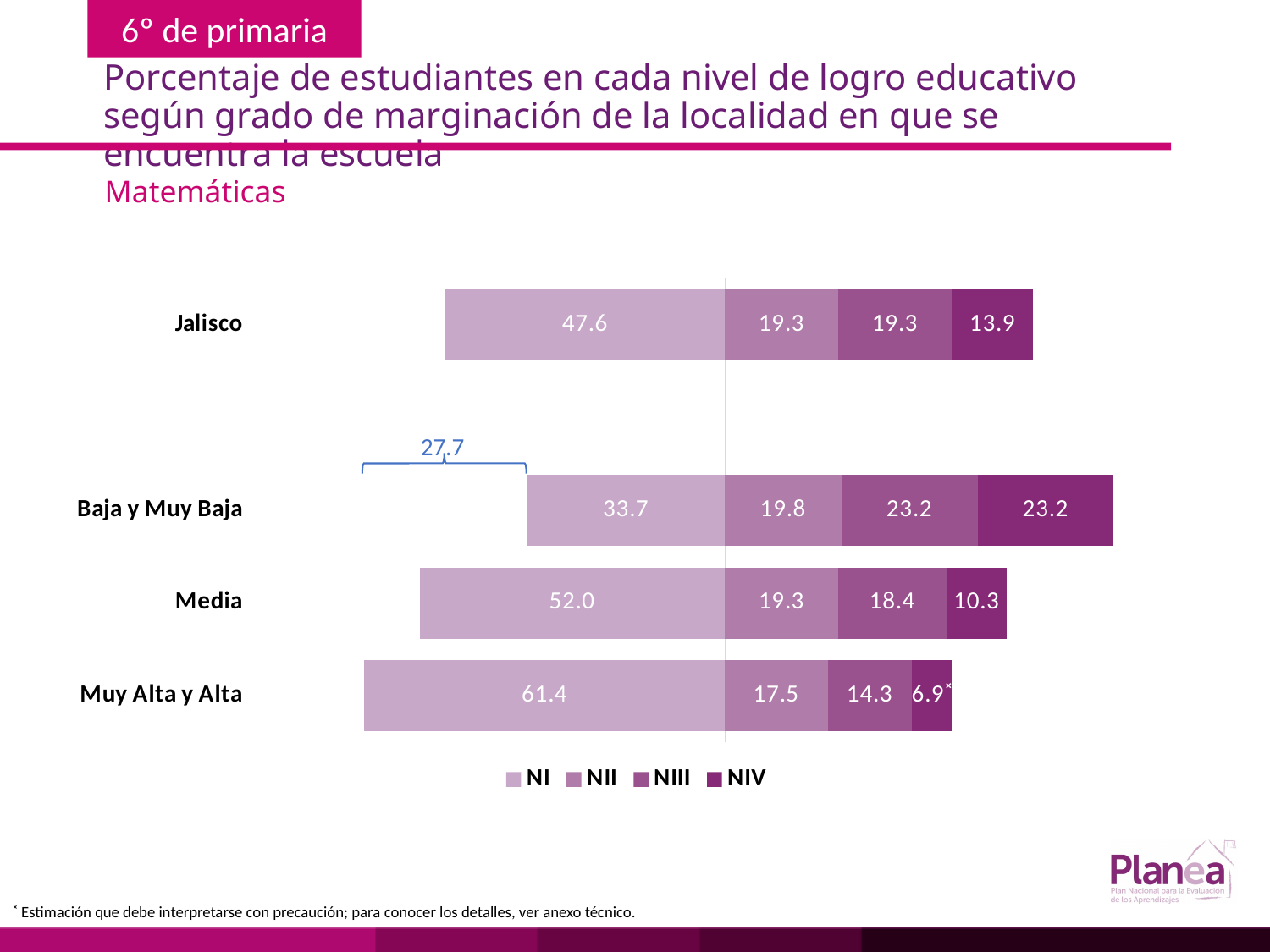
What type of chart is shown on the slide? Stacked bar chart What is the NI value for Jalisco? 47.6 Which series is shown in the lightest shade in the legend? NI Which category has the highest NI value? Muy Alta y Alta How many series does the legend list? 4 Which is larger, the NIV value for Media or the NIV value for Jalisco? Jalisco How many categories are plotted on the chart? 4 What is the difference between the NI values for Muy Alta y Alta and Baja y Muy Baja? 27.7 Which category has the lowest NIV value? Muy Alta y Alta What is the NII value for Muy Alta y Alta? 17.5 What is the NIII value for Media? 18.4 What is the NIV value for Baja y Muy Baja? 23.2